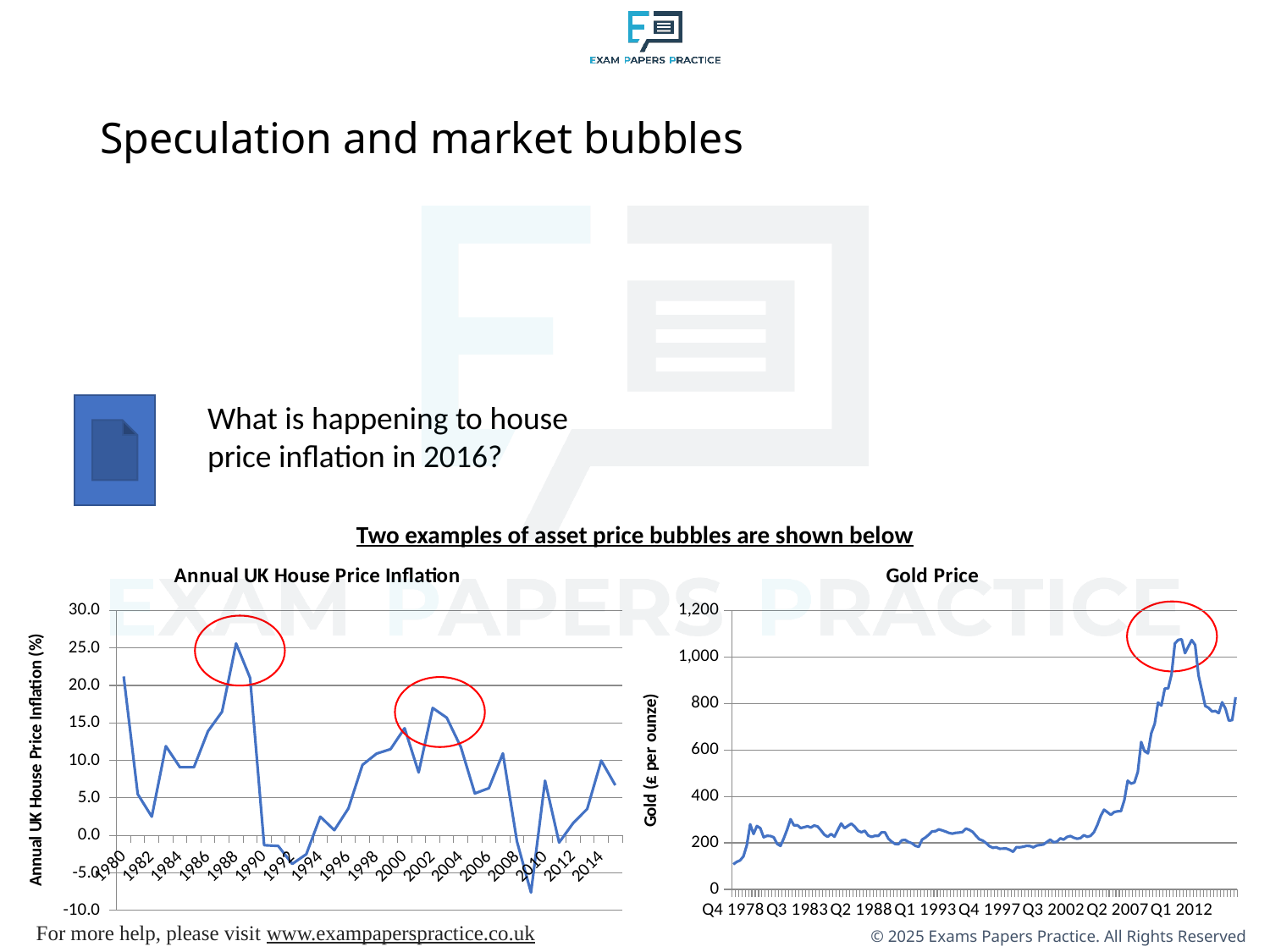
In the Annual UK House Price Inflation chart, is the peak value around 1988 greater or less than 20.0? greater In the Annual UK House Price Inflation chart, which peak is higher: the one circled around 1988 or the one circled around 2003? the one around 1988 In the Gold Price chart, is the final value on the right greater or less than 600? greater In the Annual UK House Price Inflation chart, is the value for 1982 greater or less than 5.0? less In the Gold Price chart, does the gold price overall rise or fall from Q4 1978 to the end of the series? rise What kind of chart is the Gold Price chart? line chart What is the y-axis title of the Gold Price chart? Gold (£ per ounze) What is the y-axis title of the Annual UK House Price Inflation chart? Annual UK House Price Inflation (%) What kind of chart is the Annual UK House Price Inflation chart? line chart